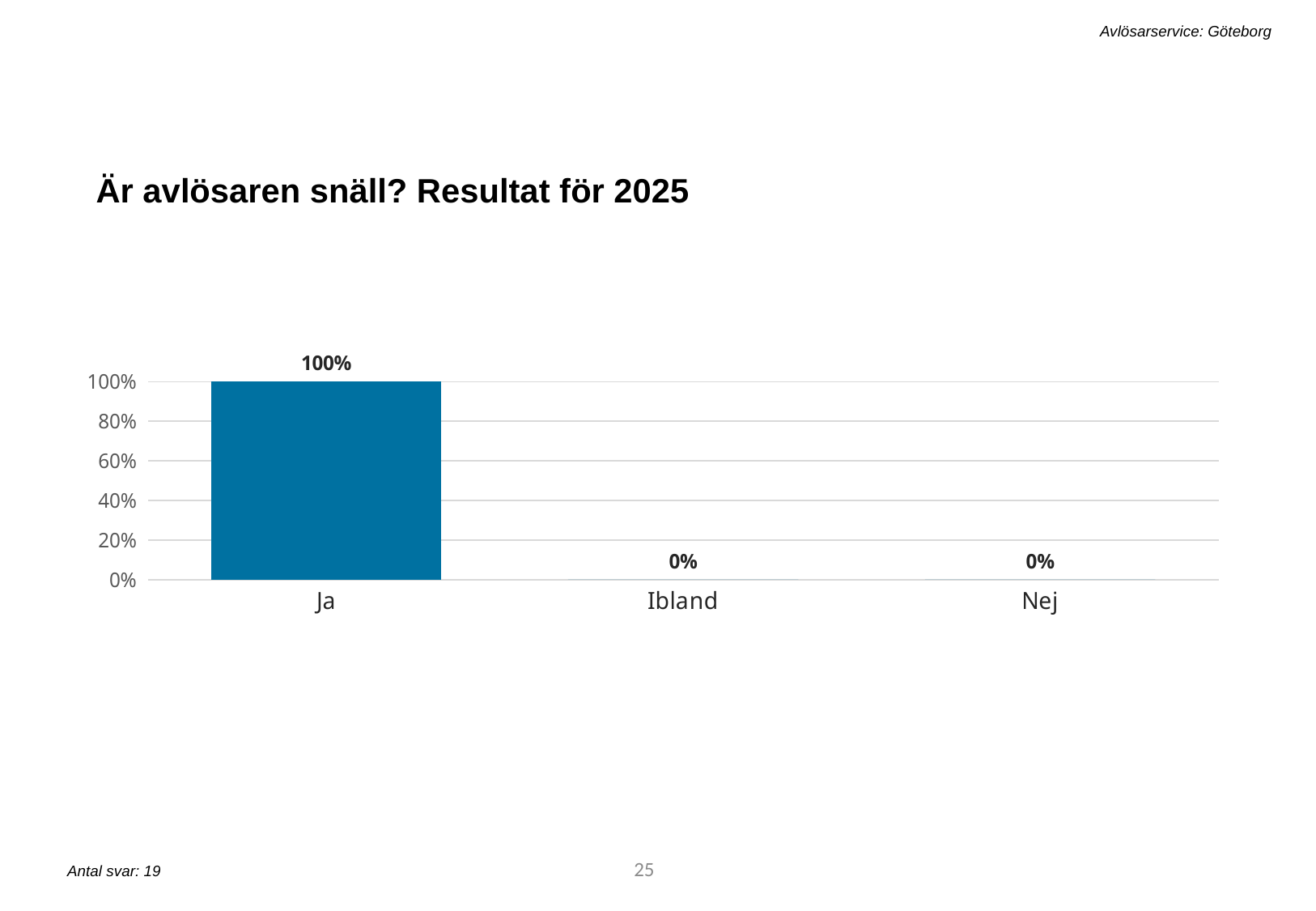
Which is larger, the value for Ja or the value for Ibland? Ja What is the value for Ja? 100% What is the difference between the values for Ja and Nej? 100% What kind of chart is shown on the slide? bar chart What is the value for Nej? 0% What is the value for Ibland? 0% What is the title of the slide? Är avlösaren snäll? Resultat för 2025 What is the highest value shown on the y axis? 100% What is the total of the values for Ibland and Nej? 0% Is the value for Ja greater or less than 80%? greater How many categories are shown on the x axis? 3 Which category has the highest value? Ja